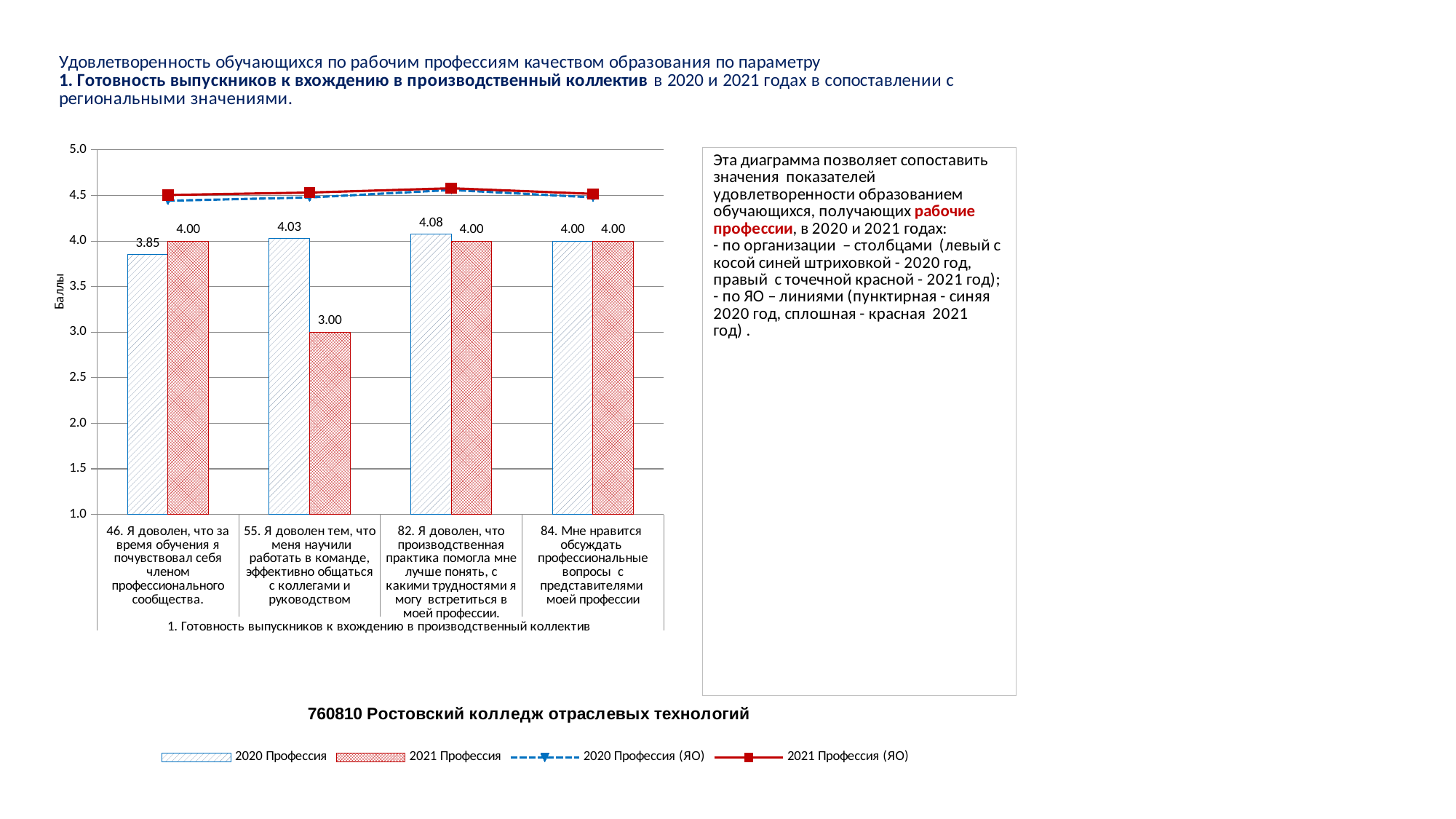
What is the value of the 2020 Профессия bar for category 46 (Я доволен, что за время обучения я почувствовал себя членом профессионального сообщества)? 3.85 Which category has the lowest 2021 Профессия bar? 55. Я доволен тем, что меня научили работать в команде, эффективно общаться с коллегами и руководством For category 46, which is larger: the 2020 Профессия bar or the 2021 Профессия bar? 2021 Профессия Which category has the highest 2020 Профессия bar? 82. Я доволен, что производственная практика помогла мне лучше понять, с какими трудностями я могу встретиться в моей профессии. Is the 2021 Профессия (ЯО) line value for category 82 greater or less than 4.0? greater What is the value of the 2021 Профессия bar for category 55 (Я доволен тем, что меня научили работать в команде)? 3.00 How many series does the legend list? 4 What is the label of the vertical axis? Баллы What is the value of the 2020 Профессия bar for category 82 (производственная практика помогла мне лучше понять)? 4.08 What is the value of the 2021 Профессия bar for category 84 (Мне нравится обсуждать профессиональные вопросы)? 4.00 How many categories are shown on the x axis of the chart? 4 What is the difference between the 2020 Профессия and 2021 Профессия values for category 55? 1.03